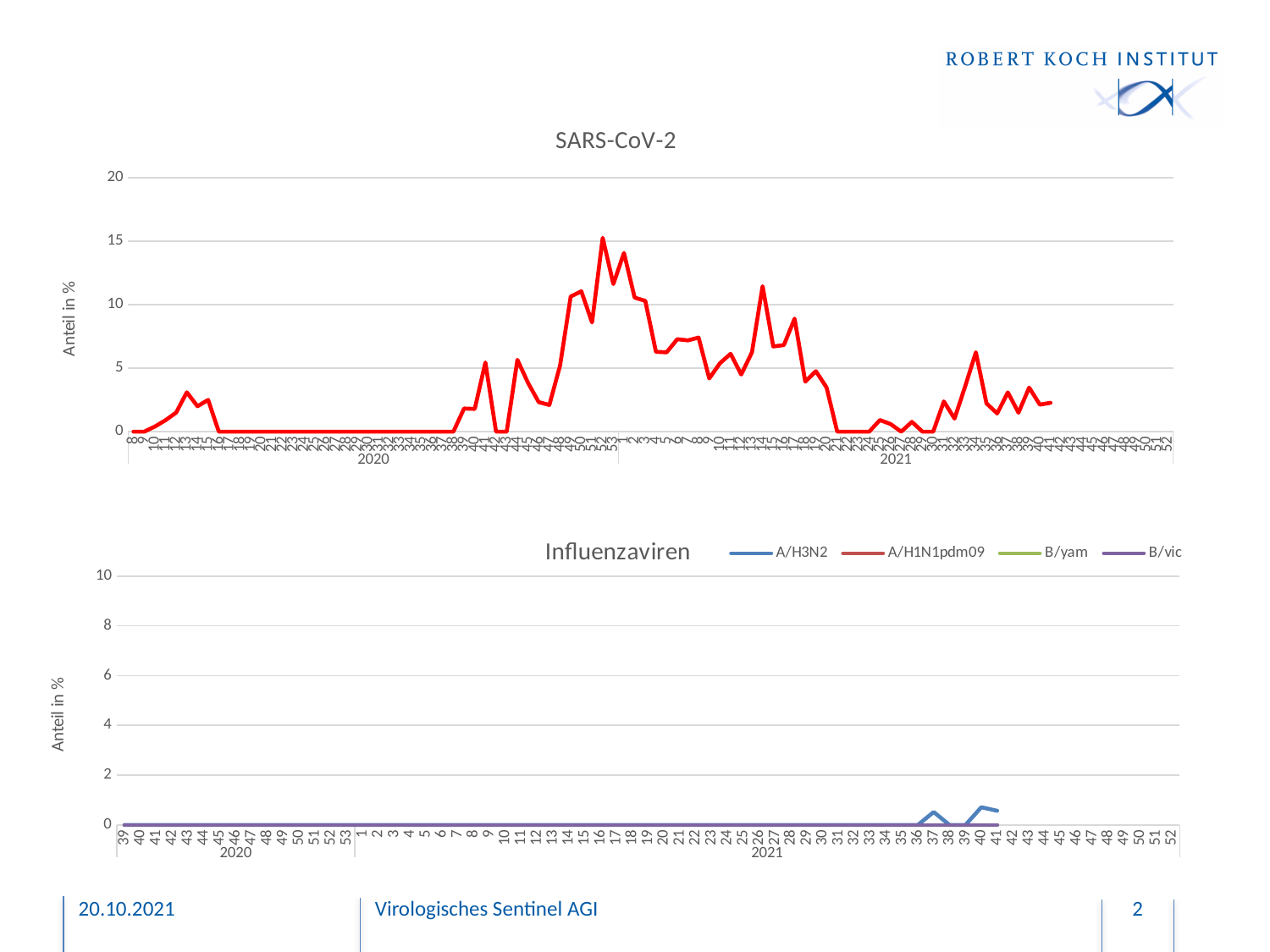
What is the highest tick value on the y-axis of the Influenzaviren chart? 10 What kind of chart is the Influenzaviren chart at the bottom of the slide? line chart What is the y-axis title of the SARS-CoV-2 chart? Anteil in % In the SARS-CoV-2 chart, is the highest value reached by the line greater or less than 10? greater In the Influenzaviren chart, which series is the only one that visibly rises above 0? A/H3N2 What is the highest tick value on the y-axis of the SARS-CoV-2 chart? 20 How many series does the legend of the Influenzaviren chart list? 4 In the Influenzaviren chart, is the highest value of the A/H3N2 series greater or less than 2? less In the SARS-CoV-2 chart, is the value at week 30 of 2020 greater or less than 5? less In the SARS-CoV-2 chart, does the line generally rise or fall between week 38 and week 53 of 2020? rise What kind of chart is the SARS-CoV-2 chart at the top of the slide? line chart Which series are listed in the legend of the Influenzaviren chart? A/H3N2, A/H1N1pdm09, B/yam, B/vic